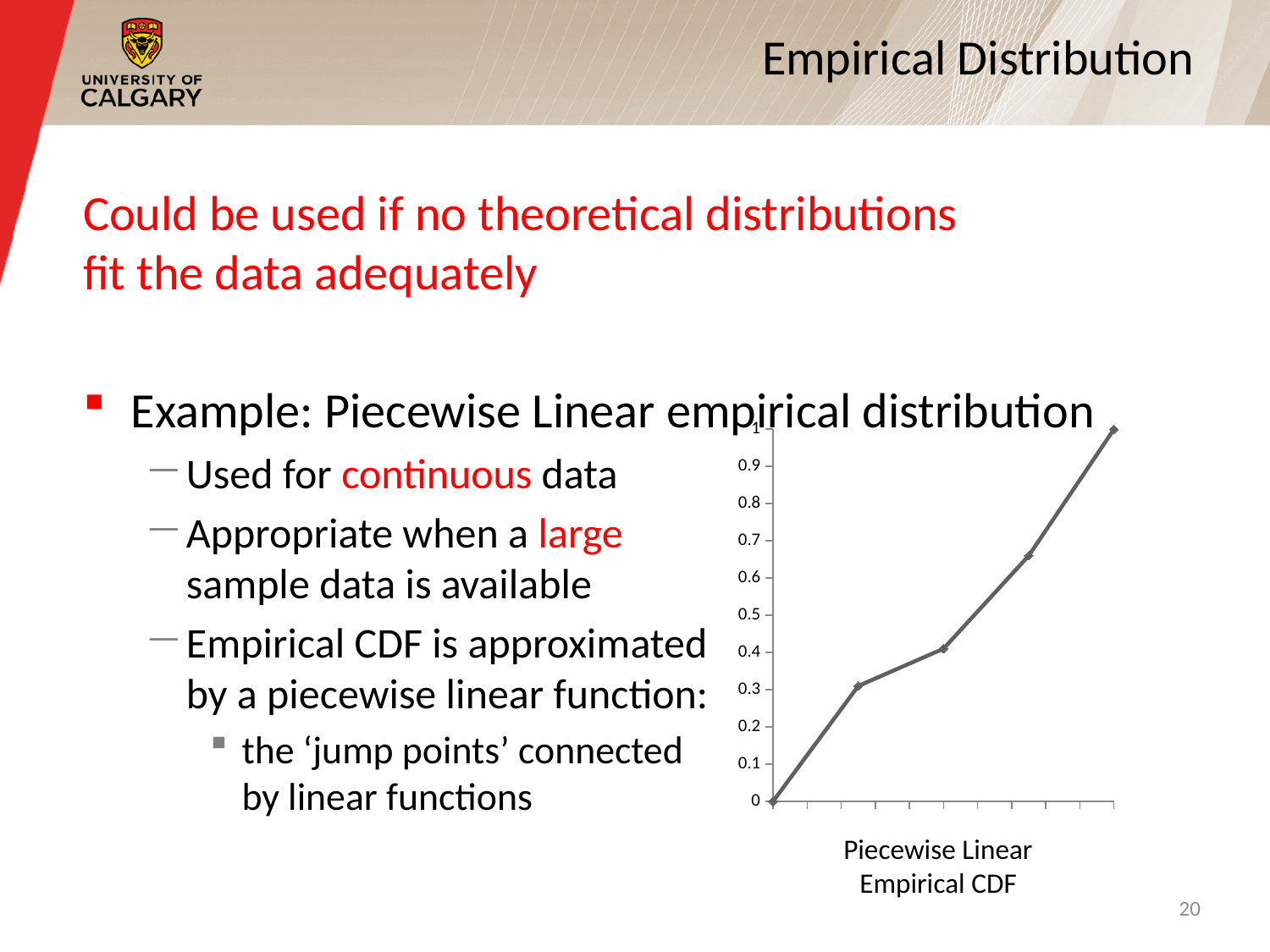
Is the value of the third point on the line chart greater or less than 0.3? greater What is the value of the first (leftmost) point on the line chart? 0 How many data points are plotted on the line chart? 5 Is the value of the second point on the line chart greater or less than 0.4? less What kind of chart is shown on the slide? line chart What caption is shown below the line chart? Piecewise Linear Empirical CDF What is the value of the last (rightmost) point on the line chart? 1 Which is larger on the line chart, the value of the fourth point or the value of the second point? the fourth point Which point on the line chart has the lowest value? the first (leftmost) point Is the value of the fourth point on the line chart greater or less than 0.6? greater Which point on the line chart has the highest value? the last (rightmost) point Do the values on the line chart rise or fall from left to right? rise